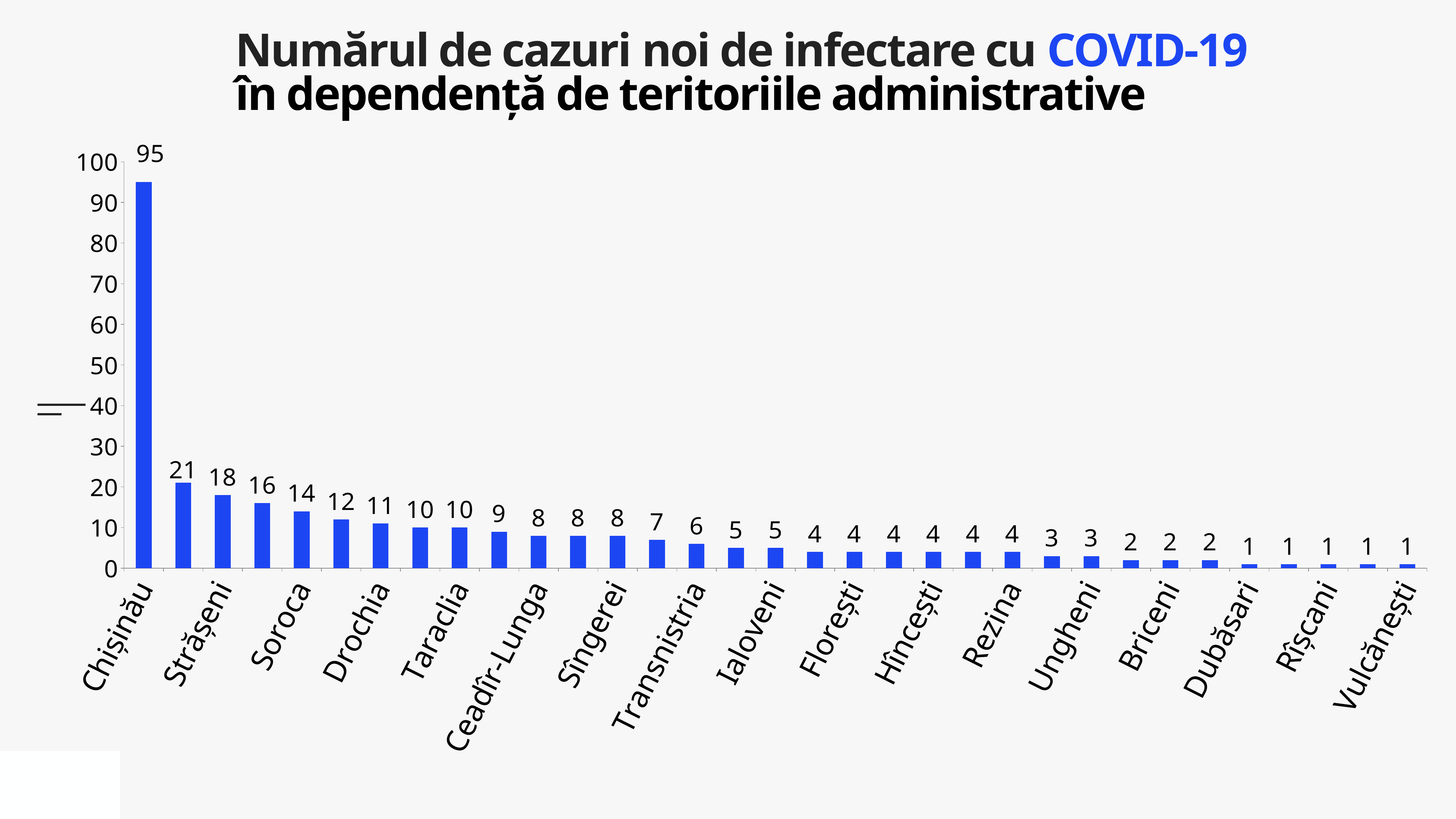
Which is larger, the value for Soroca or the value for Drochia? Soroca Is the value for Chișinău greater or less than 90? greater What is the value for Strășeni? 18 Do the values rise or fall from left to right along the x axis? fall What is the value for Chișinău? 95 What is the value for Soroca? 14 What kind of chart is shown on the slide? bar chart Which territory has the highest number of new cases? Chișinău What is the value for Taraclia? 10 What is the value for Drochia? 11 What is the highest value shown on the vertical axis? 100 What is the difference between the values for Chișinău and Strășeni? 77